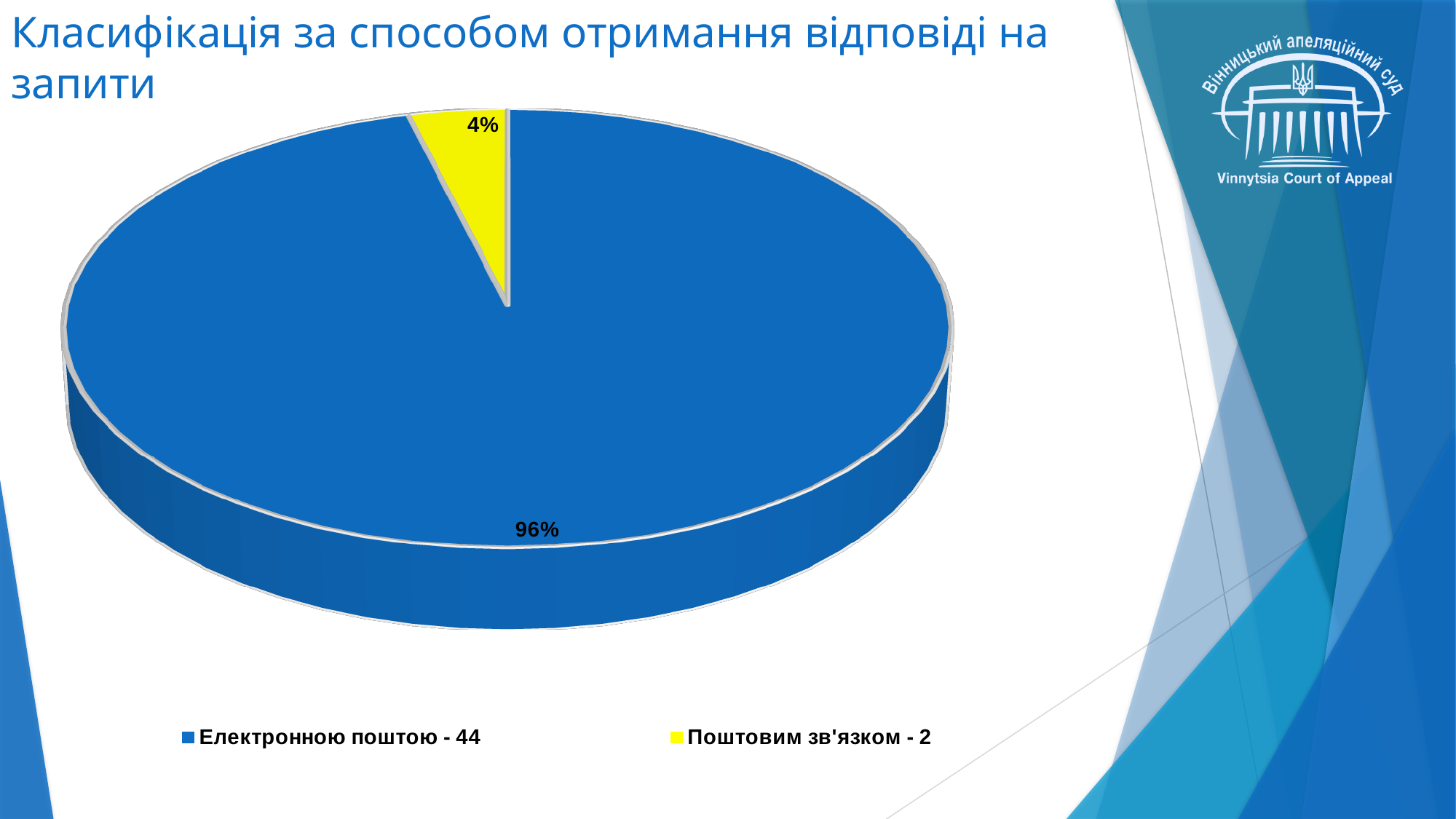
How many entries does the legend list? 2 Is the share for "Електронною поштою" greater or less than 50%? greater Which category has the smallest slice of the pie? Поштовим зв'язком - 2 What colour is the slice for "Поштовим зв'язком - 2"? Yellow Which category has the largest slice of the pie? Електронною поштою - 44 What kind of chart is shown on the slide? Pie chart What is the difference in percentage points between the "Електронною поштою" slice and the "Поштовим зв'язком" slice? 92 What is the title of the slide? Класифікація за способом отримання відповіді на запити What share of the pie does "Поштовим зв'язком - 2" represent? 4% Which is larger: the share for "Електронною поштою" or the share for "Поштовим зв'язком"? Електронною поштою What share of the pie does "Електронною поштою - 44" represent? 96% How many slices does the pie chart have? 2